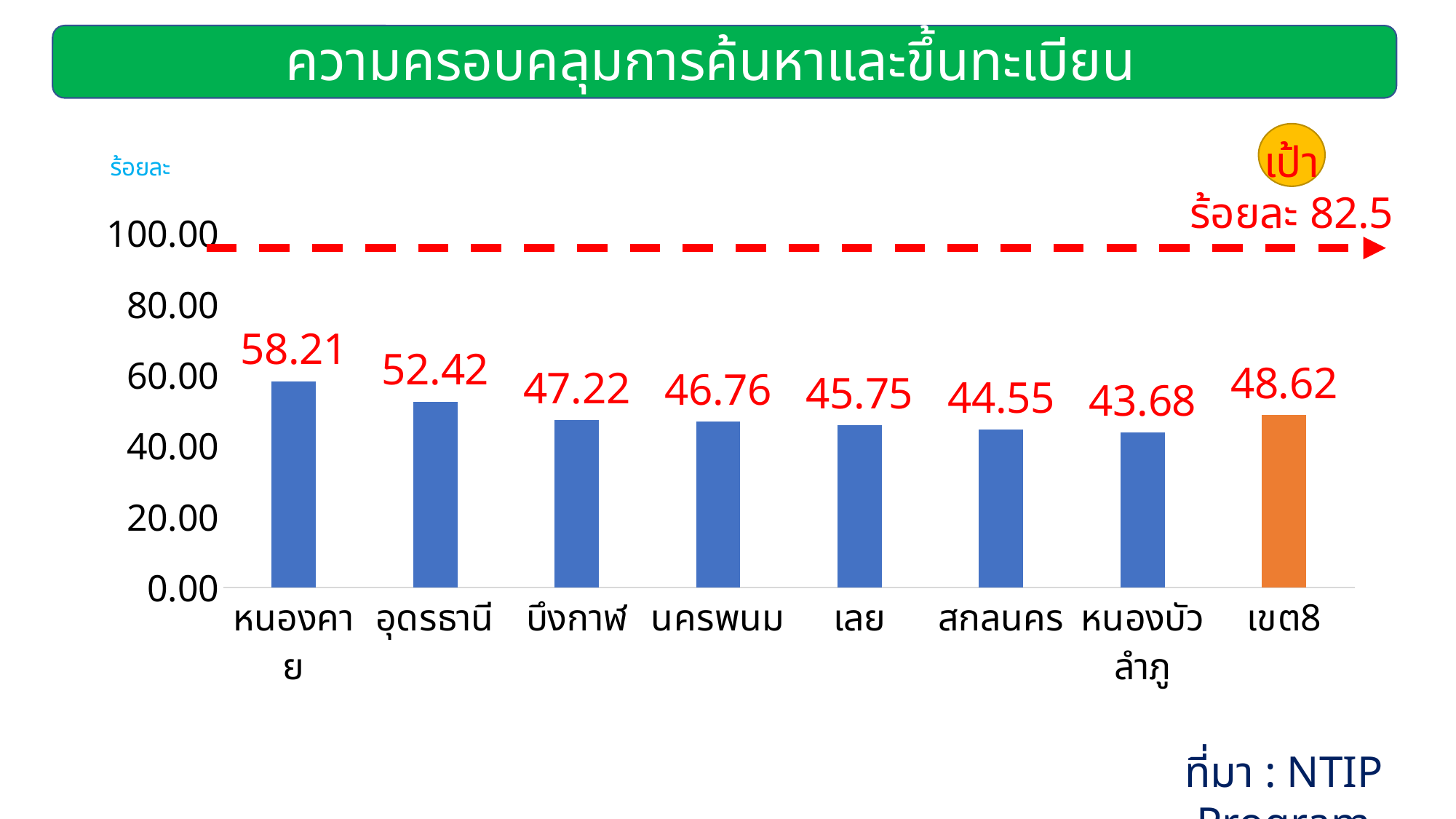
What is the value for เขต8? 48.62 Which is larger, the value for เลย or the value for สกลนคร? เลย Which category has the highest value? หนองคาย Is the value for บึงกาฬ greater or less than 60.00? less What is the value for หนองคาย? 58.21 Which bar is coloured orange instead of blue? เขต8 What kind of chart is shown on the slide? bar chart How many categories are shown on the x axis? 8 What is the difference between the values for หนองคาย and อุดรธานี? 5.79 Which category has the lowest value? หนองบัวลำภู What is the value for หนองบัวลำภู? 43.68 What target value is shown by the dashed red line? ร้อยละ 82.5